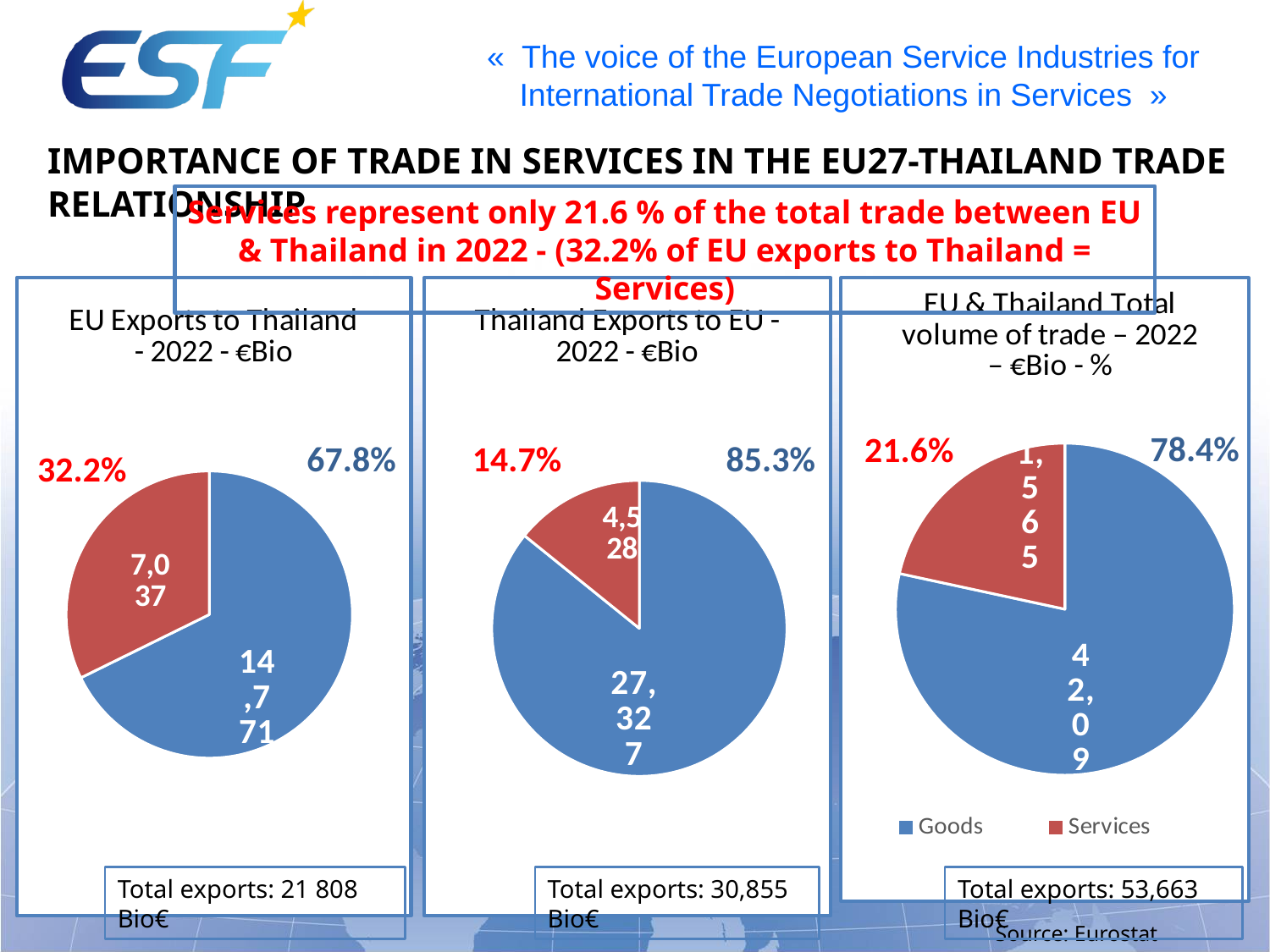
In the 'EU Exports to Thailand - 2022' chart, which slice is larger, Goods or Services? Goods In the 'Thailand Exports to EU - 2022' chart, what is the value of the Services slice? 4,528 What kind of charts are shown on the slide? Pie charts In the 'EU Exports to Thailand - 2022' chart, what is the value of the Goods slice? 14,771 In the 'EU & Thailand Total volume of trade - 2022' chart, what share is Goods? 78.4% In the 'EU Exports to Thailand - 2022' chart, what is the value of the Services slice? 7,037 In the 'EU Exports to Thailand - 2022' chart, what share of exports is Services? 32.2% In the 'Thailand Exports to EU - 2022' chart, what is the value of the Goods slice? 27,327 In the 'EU Exports to Thailand - 2022' chart, what is the difference in percentage points between the Goods share and the Services share? 35.6 percentage points In the 'Thailand Exports to EU - 2022' chart, what share of exports is Goods? 85.3% How many entries does the legend of the 'EU & Thailand Total volume of trade' chart list? 2